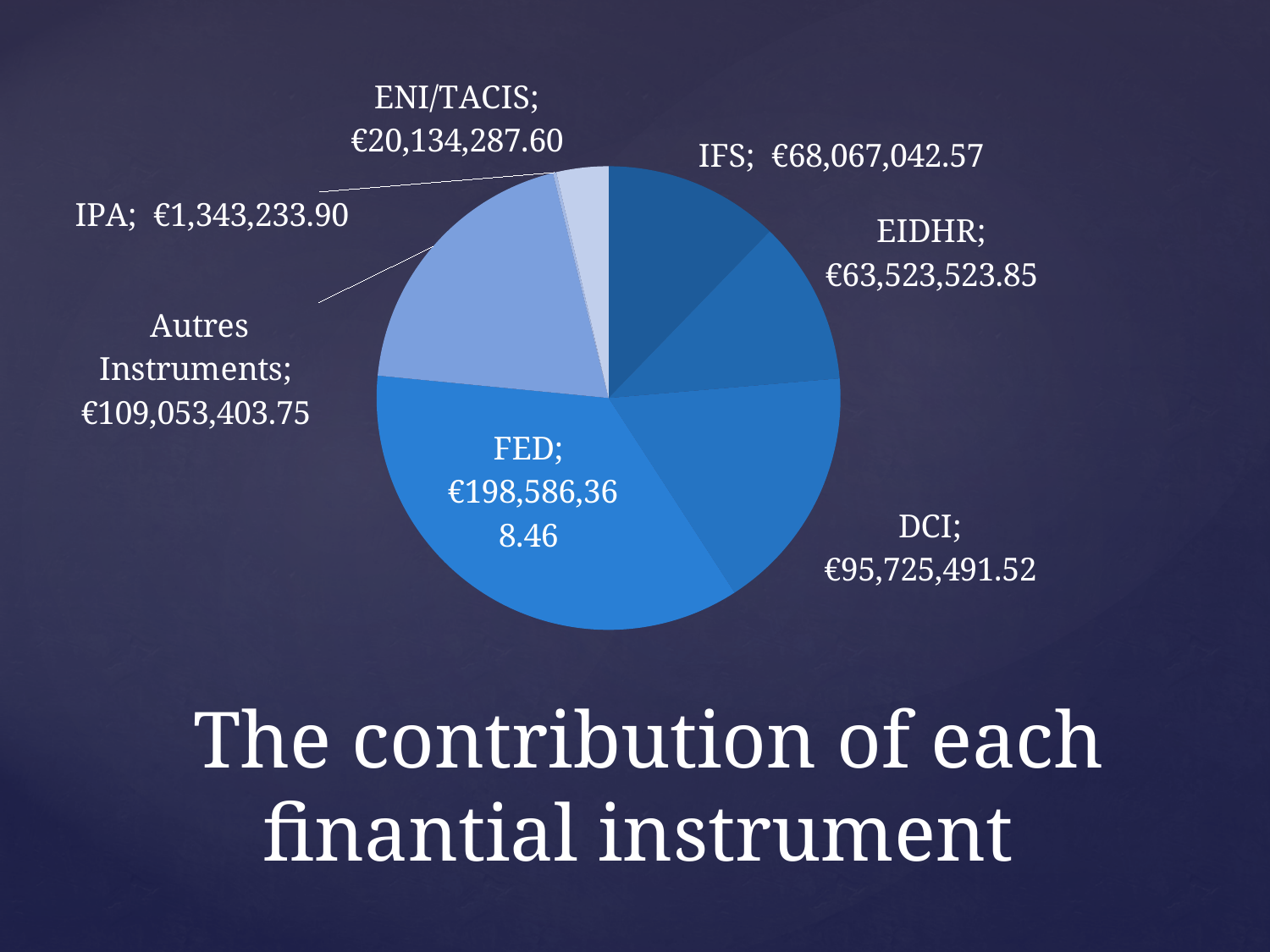
What is the value for DCI? €95,725,491.52 What kind of chart is shown on the slide? pie chart How many instruments (slices) are shown in the pie chart? 7 Which instrument has the smallest contribution? IPA What is the difference between the IFS and EIDHR contributions? €4,543,518.72 What is the value for ENI/TACIS? €20,134,287.60 What is the title shown below the chart? The contribution of each finantial instrument What is the difference between the FED and Autres Instruments contributions? €89,532,964.71 What is the value for Autres Instruments? €109,053,403.75 Which is larger, the contribution of DCI or of Autres Instruments? Autres Instruments Which instrument has the largest contribution? FED What is the value for FED? €198,586,368.46